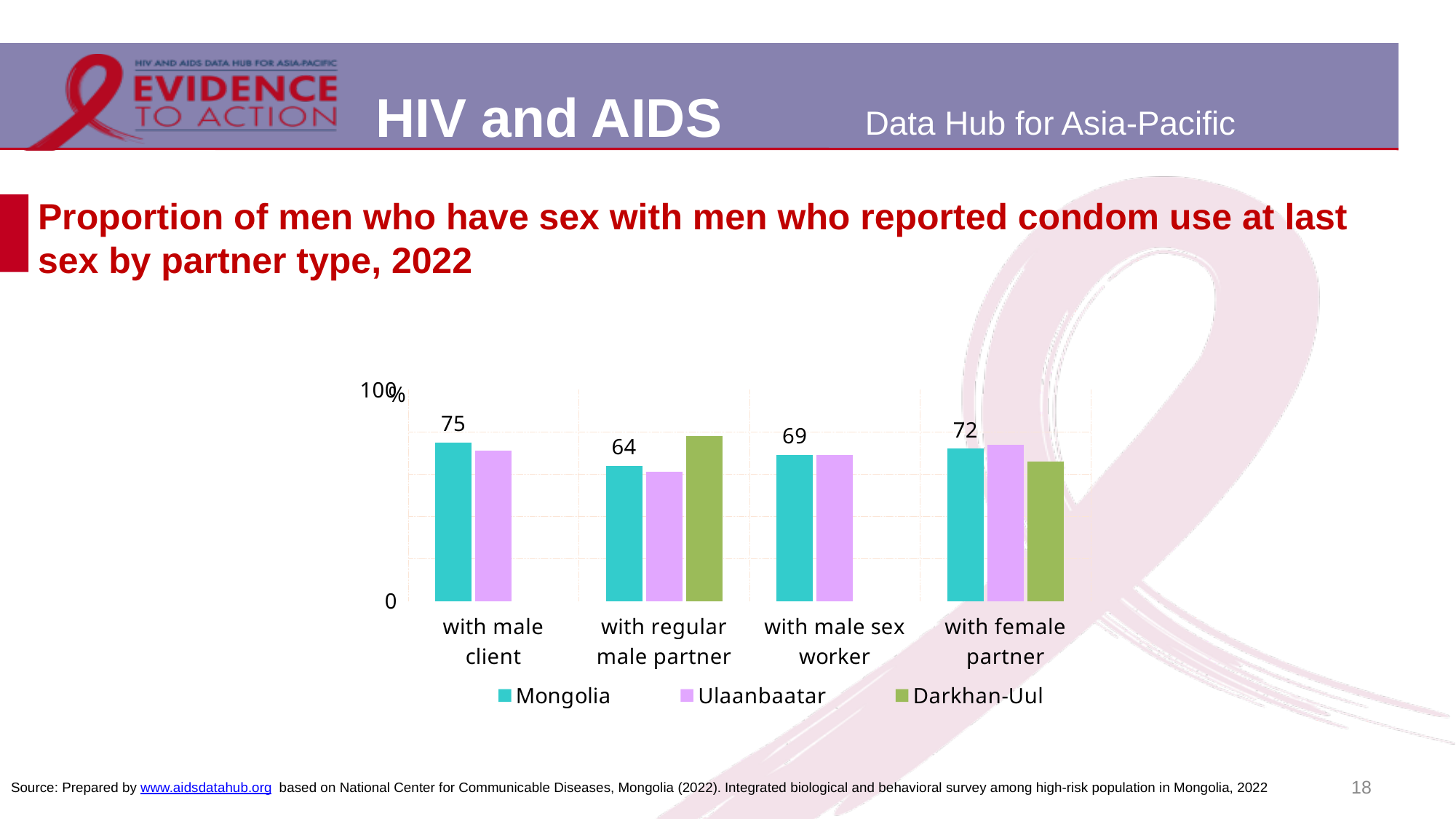
How many series does the legend list? 3 What is the value for Mongolia for 'with regular male partner'? 64 What is the difference between the Mongolia values for 'with male client' and 'with regular male partner'? 11 For 'with regular male partner', which series has the tallest bar? Darkhan-Uul What is the value for Mongolia for 'with female partner'? 72 For the Mongolia series, which partner type has the lowest value? with regular male partner For 'with female partner', is the Ulaanbaatar bar or the Darkhan-Uul bar taller? Ulaanbaatar For the Mongolia series, which partner type has the highest value? with male client What is the value for Mongolia for 'with male sex worker'? 69 How many partner-type categories are shown on the x axis? 4 What is the value for Mongolia for 'with male client'? 75 What kind of chart is shown on the slide? Bar chart